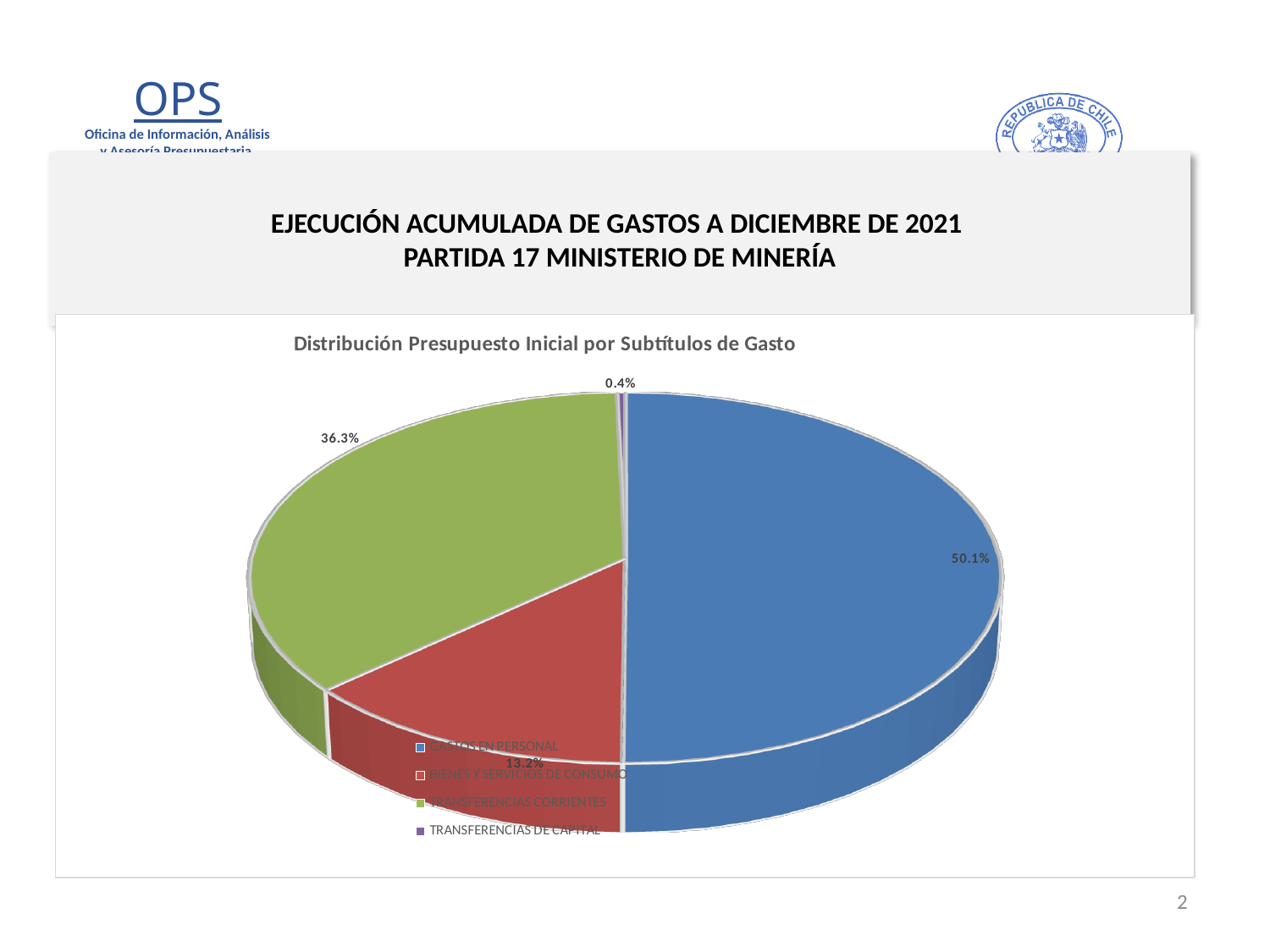
What colour is the slice for TRANSFERENCIAS CORRIENTES? Green What share of the pie does TRANSFERENCIAS CORRIENTES represent? 36.3% Which is larger, the share for BIENES Y SERVICIOS DE CONSUMO or the share for TRANSFERENCIAS CORRIENTES? TRANSFERENCIAS CORRIENTES How many categories does the legend list? 4 What is the chart's title? Distribución Presupuesto Inicial por Subtítulos de Gasto What share of the pie does BIENES Y SERVICIOS DE CONSUMO represent? 13.2% What kind of chart is shown on the slide? Pie chart What is the difference in percentage points between GASTOS EN PERSONAL and TRANSFERENCIAS CORRIENTES? 13.8 What share of the pie does GASTOS EN PERSONAL represent? 50.1% What share of the pie does TRANSFERENCIAS DE CAPITAL represent? 0.4% Which category has the largest share of the pie? GASTOS EN PERSONAL Which category has the smallest share of the pie? TRANSFERENCIAS DE CAPITAL